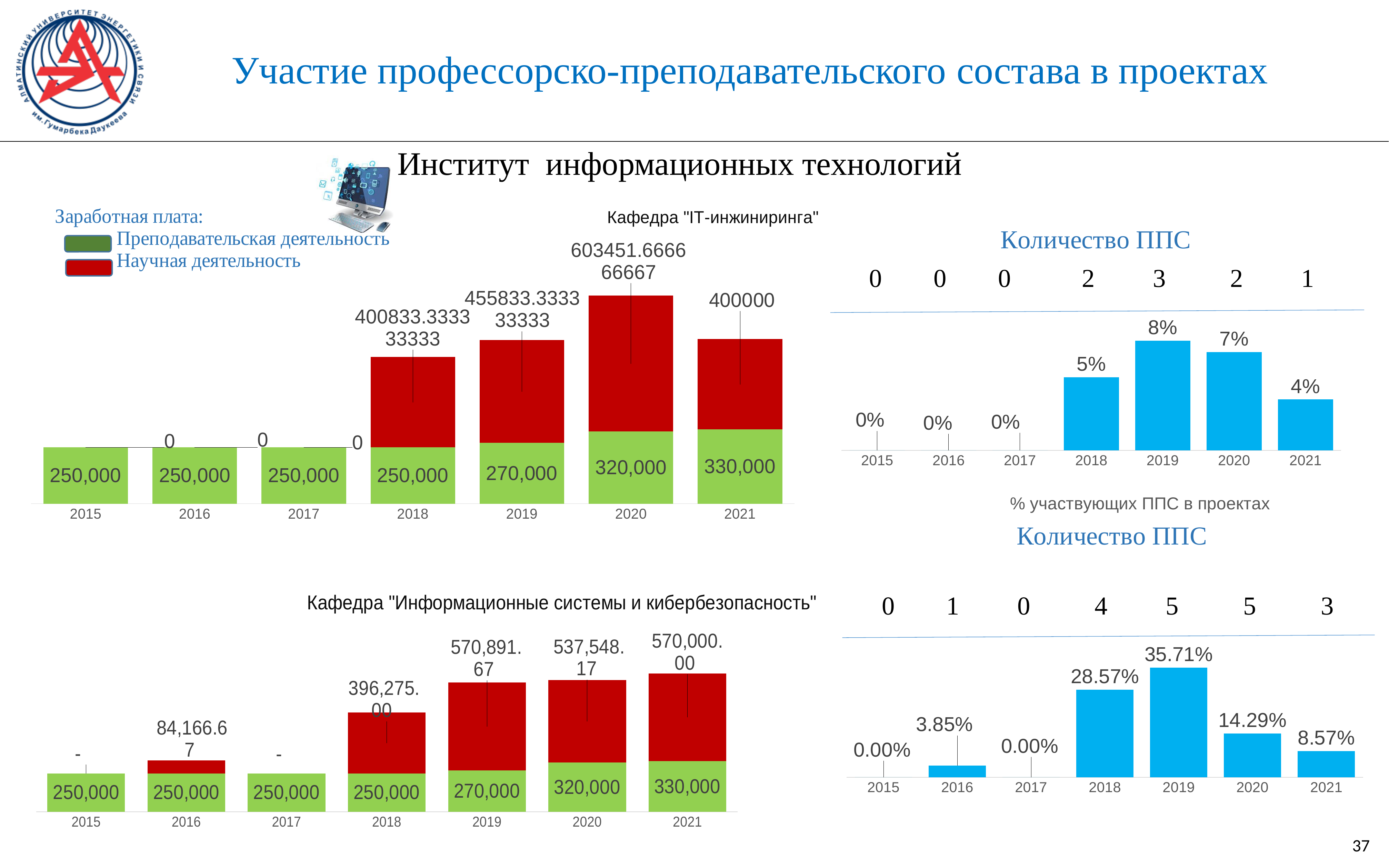
What kind of chart is the chart titled Кафедра "IT-инжиниринга"? Stacked bar chart In the bottom-right chart (% участвующих ППС в проектах), what is the value for 2018? 28.57% How many years are shown on the x axis of the chart titled Кафедра "IT-инжиниринга"? 7 In the bottom-right chart, what is the difference between the values for 2019 and 2020? 21.42% In the chart titled Кафедра "IT-инжиниринга", what is the value of Преподавательская деятельность for 2020? 320,000 How many series does the Заработная плата legend list? 2 In the chart titled Кафедра "Информационные системы и кибербезопасность", what is the difference between the Преподавательская деятельность values for 2021 and 2015? 80,000 In the top-right chart (% участвующих ППС в проектах), which year from 2018 to 2021 has the lowest value? 2021 In the chart titled Кафедра "Информационные системы и кибербезопасность", what is the value of Научная деятельность for 2016? 84,166.67 In the chart titled Кафедра "IT-инжиниринга", what is the value of Научная деятельность for 2021? 400000 In the bottom-right chart, which is larger: the value for 2020 or the value for 2021? 2020 In the top-right chart (% участвующих ППС в проектах), which year has the highest value? 2019